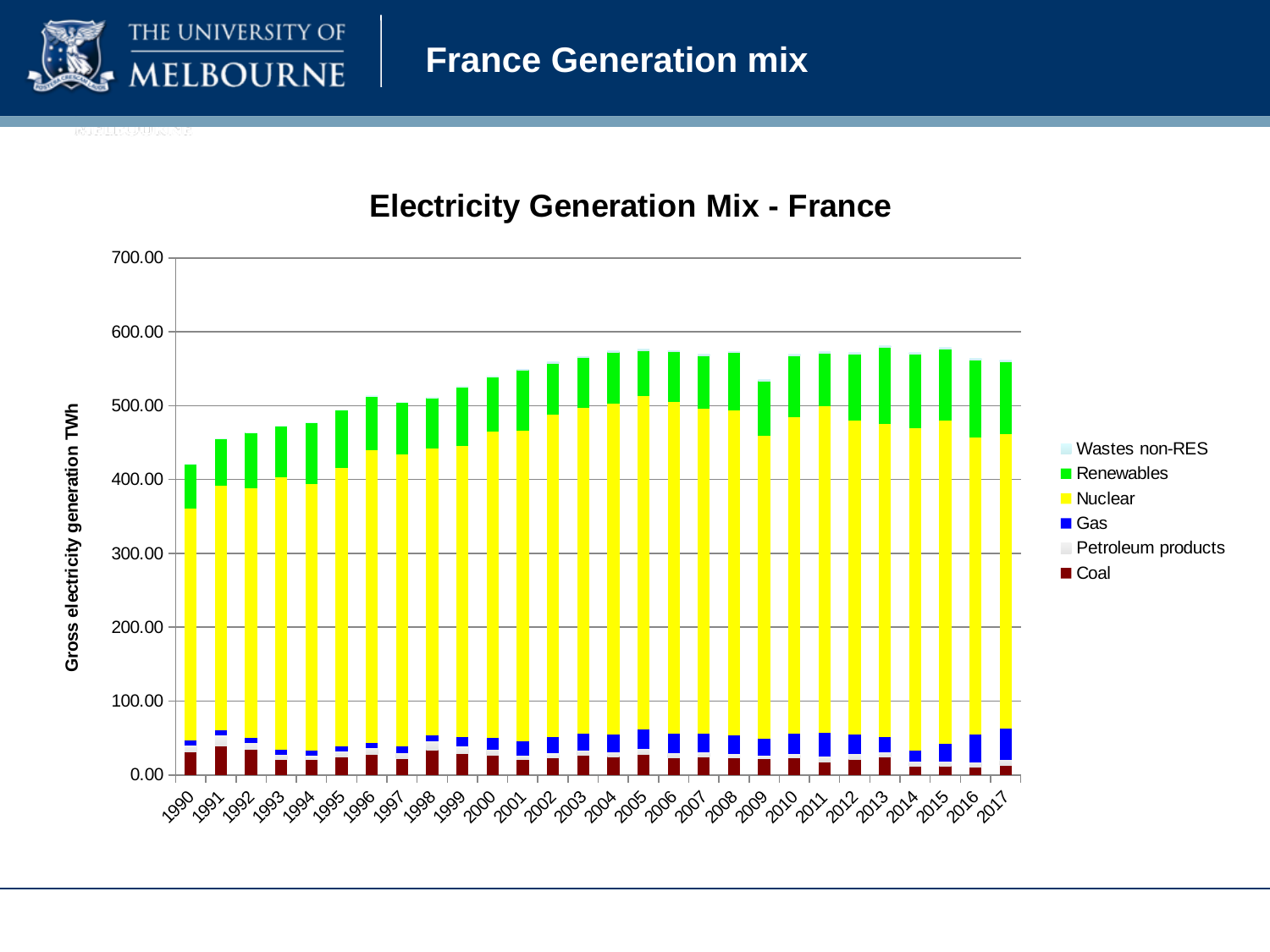
Is the total generation for 1990 greater or less than 500.00? less Which year has the lowest total gross electricity generation? 1990 What kind of chart is shown on the slide? Stacked bar chart Which year has the larger total generation, 1990 or 2017? 2017 Is the total generation for 2013 greater or less than 500.00? greater Is the total generation for 2005 greater or less than 600.00? less Which series makes up the largest part of each bar? Nuclear How many series does the legend list? 6 Does total generation generally rise or fall from 1990 to 2005? rise What is the label of the vertical axis? Gross electricity generation TWh How many years are shown along the x axis? 28 What is the title of the chart? Electricity Generation Mix - France